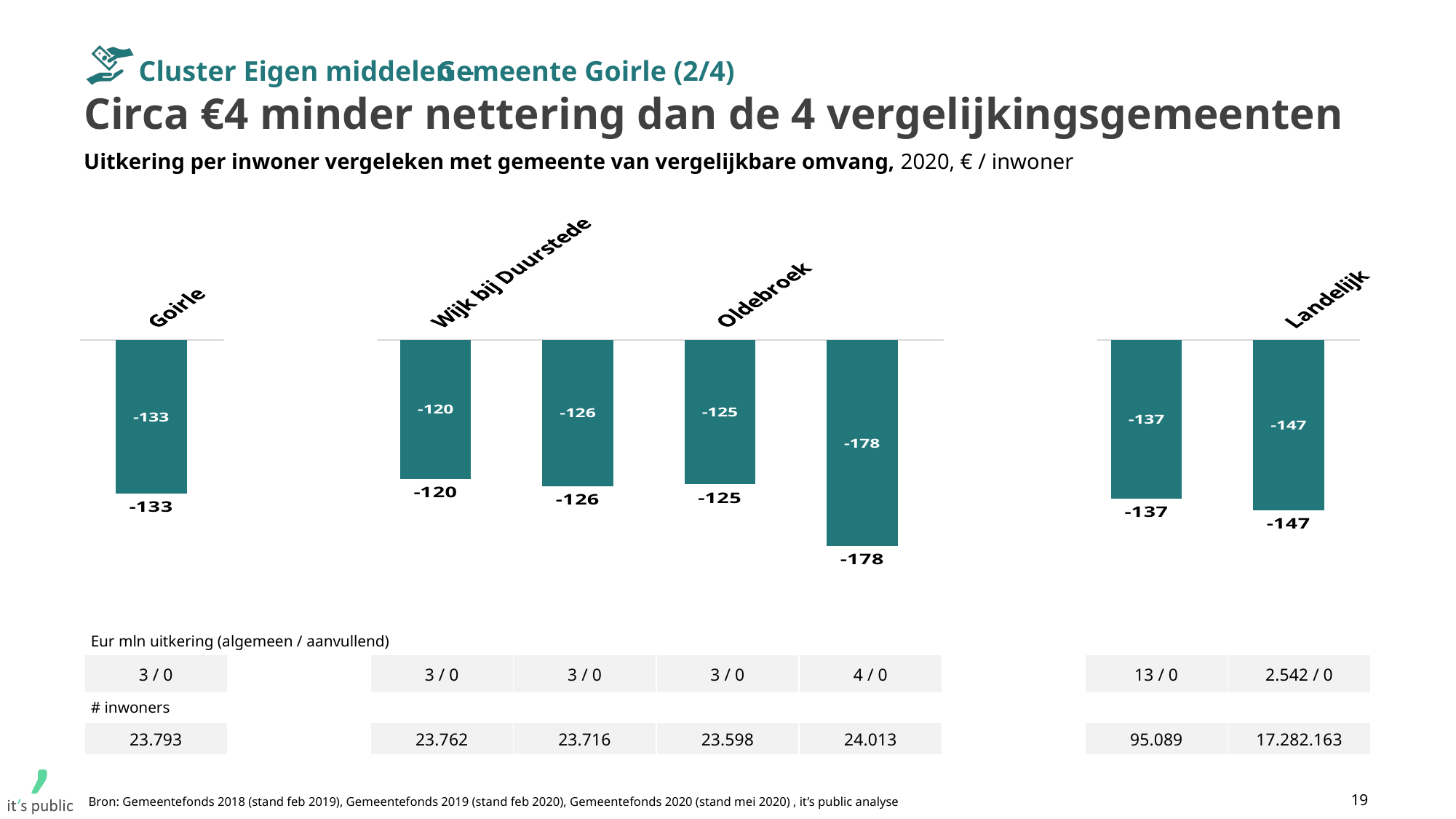
What is the value shown for Oldebroek? -125 What is the difference between the values for Goirle (-133) and Landelijk (-147)? 14 Which bar extends further below zero, Wijk bij Duurstede or Oldebroek? Oldebroek What is the difference between the values for Wijk bij Duurstede (-120) and Oldebroek (-125)? 5 What is the lowest (most negative) value shown on the chart? -178 What is the value shown for Landelijk? -147 What is the value shown for Wijk bij Duurstede? -120 What is the value shown for Goirle? -133 How many bars are plotted on the chart? 7 Which bar extends further below zero, Goirle or Landelijk? Landelijk What kind of chart is shown on the slide? Bar chart What unit does the chart subtitle say the values are in? € / inwoner